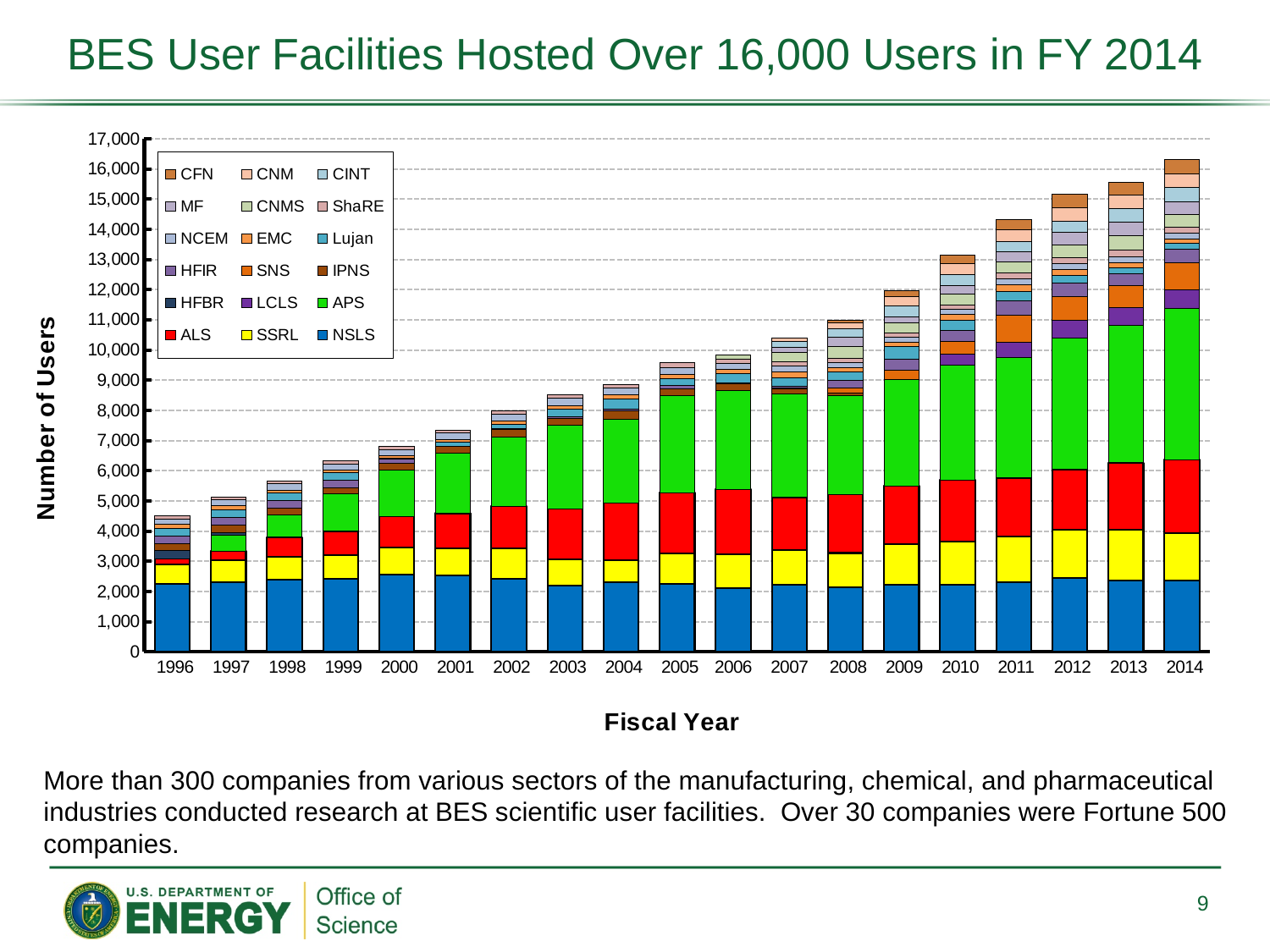
Is the total number of users in 2010 greater or less than 12,000? greater Is the total number of users in 2005 greater or less than 10,000? less Is the total number of users in 2014 greater or less than 16,000? greater What kind of chart is shown on the slide? Stacked bar chart What is the title of the chart's y axis? Number of Users Which fiscal year has the lowest total number of users? 1996 How many series does the chart's legend list? 18 Which fiscal year has a larger total number of users, 2008 or 2012? 2012 Which fiscal year has the highest total number of users? 2014 How many fiscal years are shown along the x axis of the chart? 19 Do the total numbers of users generally rise or fall from 1996 to 2014? Rise